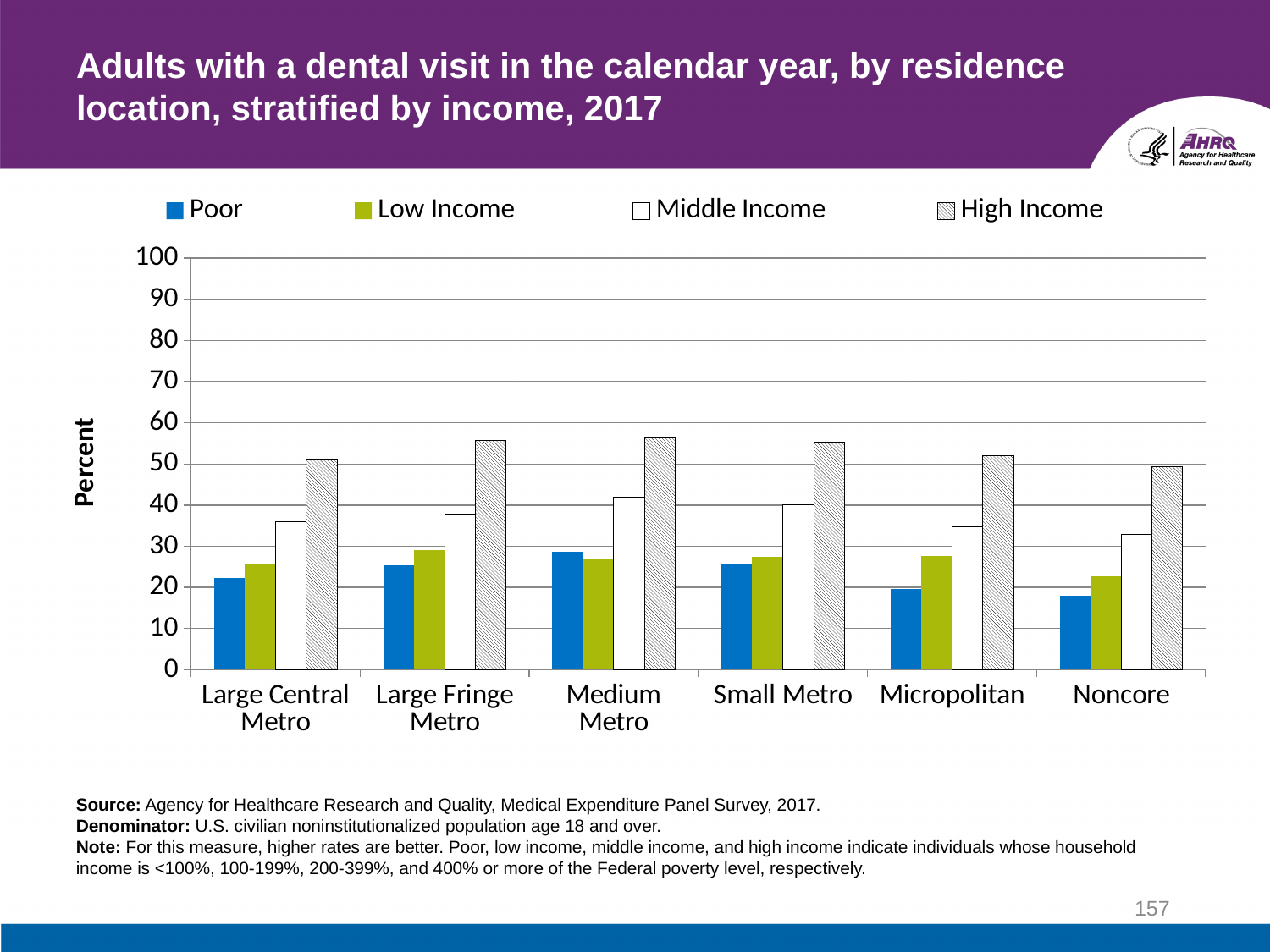
What kind of chart is shown on the slide? Bar chart How many residence location categories are shown on the x axis? 6 Which is larger for Noncore: the Poor value or the High Income value? High Income Which residence location has the lowest Poor value? Noncore Is the Low Income value for Large Central Metro greater or less than 30? less Which income group has the highest value for Large Central Metro? High Income Is the Poor value for Noncore greater or less than 20? less Is the Middle Income value for Large Fringe Metro greater or less than 40? less Which is larger: the Middle Income value for Medium Metro or the Middle Income value for Noncore? Medium Metro How many series does the legend list? 4 What is the label on the vertical axis? Percent